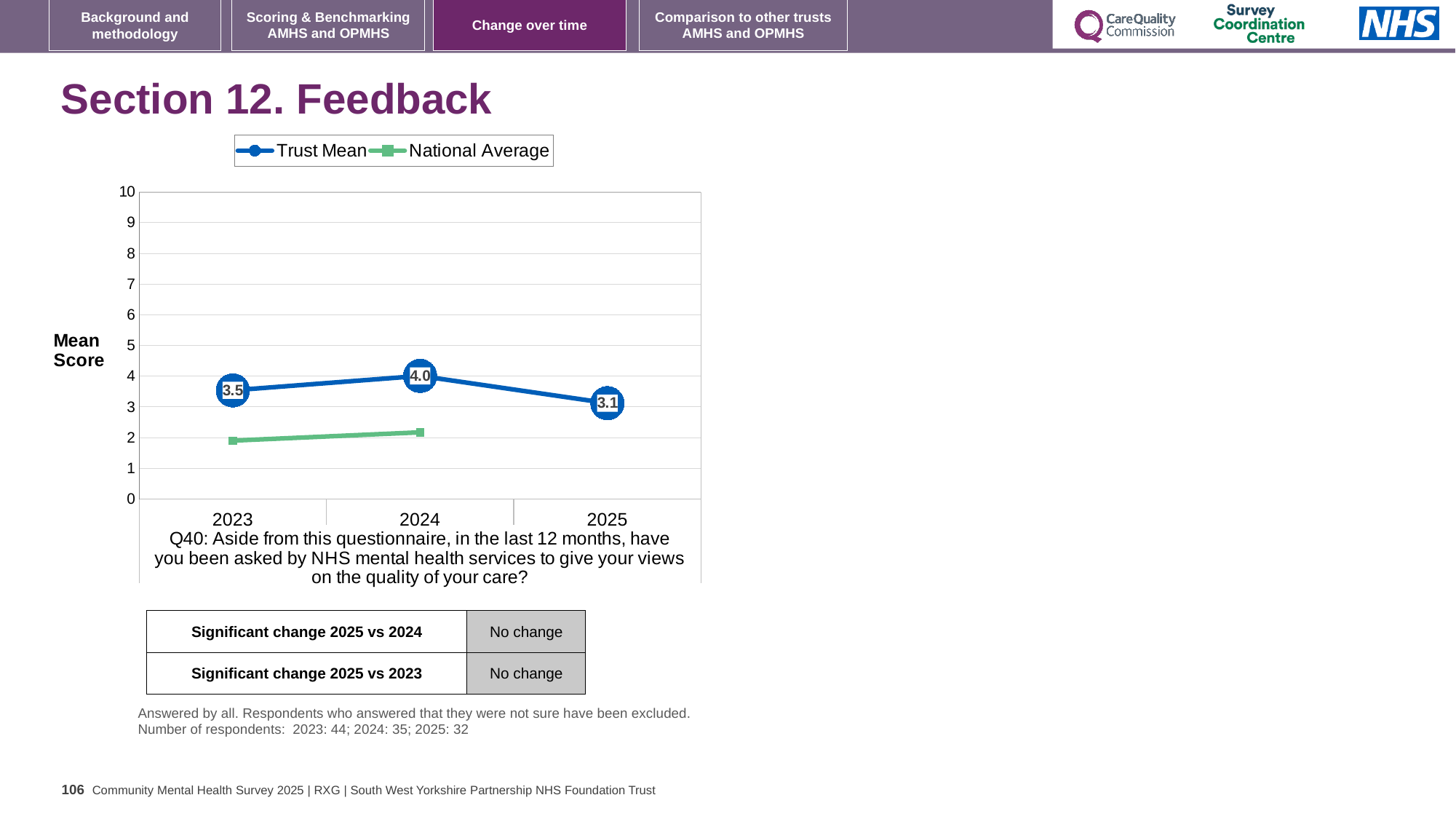
What is the Trust Mean score for 2023? 3.5 Is the National Average value for 2023 greater or less than 3? less How many years are shown on the x axis? 3 What is the difference between the Trust Mean in 2024 and in 2025? 0.9 What kind of chart is shown on the slide? Line chart What is the Trust Mean score for 2024? 4.0 Which is larger, the Trust Mean in 2023 or in 2025? 2023 How many series does the legend list? 2 In which year is the Trust Mean lowest? 2025 In which year is the Trust Mean highest? 2024 Is the National Average value for 2024 greater or less than 2? greater What is the Trust Mean score for 2025? 3.1